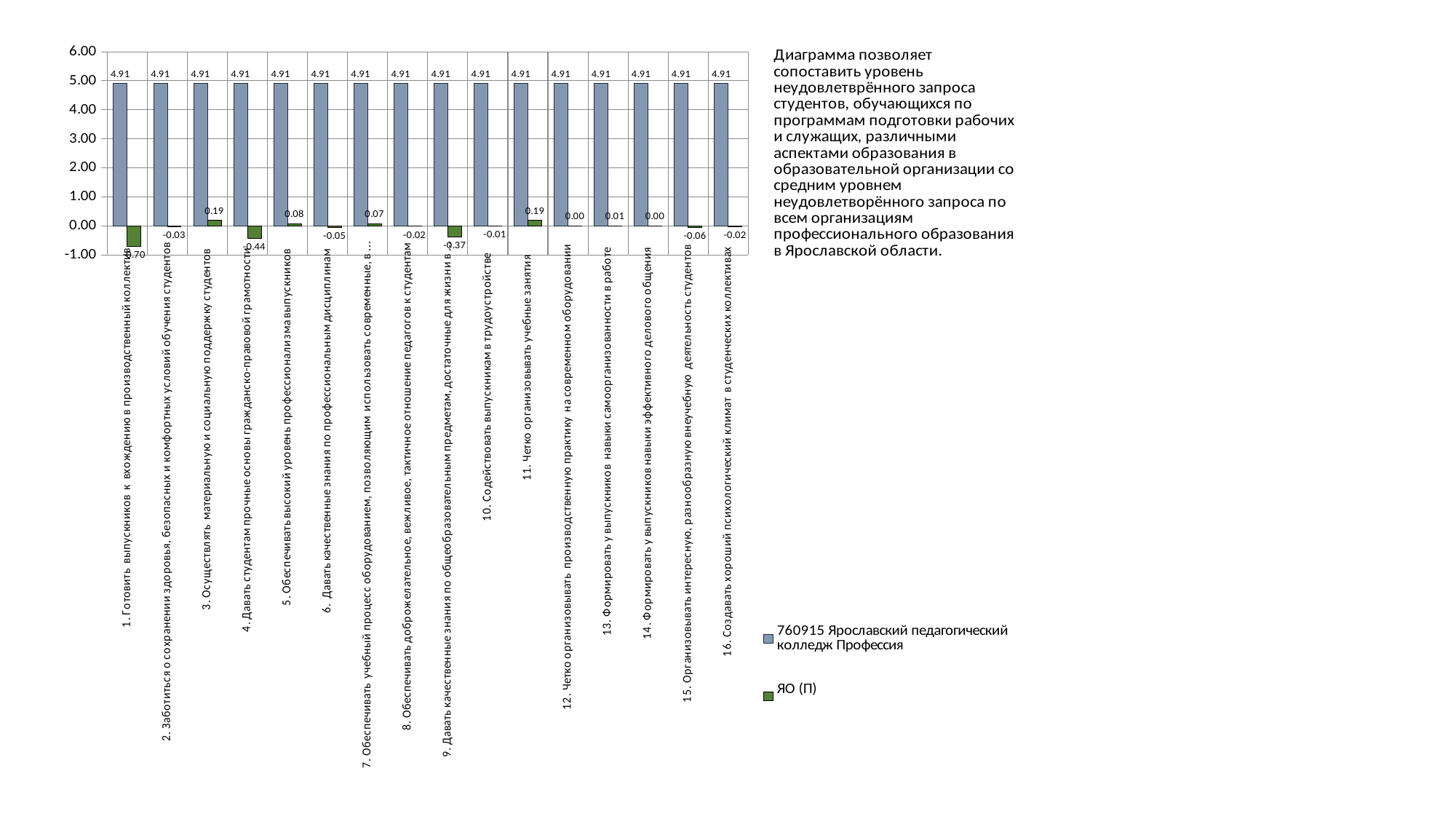
What is the value of the series "ЯО (П)" for category "15. Организовывать интересную, разнообразную внеучебную деятельность студентов"? -0.06 Is the value of the series "ЯО (П)" for category "9. Давать качественные знания по общеобразовательным предметам" greater or less than 0.00? less What type of chart is shown on the slide? bar chart What is the value of the series "760915 Ярославский педагогический колледж Профессия" for category "5. Обеспечивать высокий уровень профессионализма выпускников"? 4.91 For the series "ЯО (П)", which is larger: the value for category 5 (Обеспечивать высокий уровень профессионализма выпускников) or category 6 (Давать качественные знания по профессиональным дисциплинам)? category 5 What is the value of the series "ЯО (П)" for category "3. Осуществлять материальную и социальную поддержку студентов"? 0.19 Which category has the lowest value for the series "ЯО (П)"? 1. Готовить выпускников к вхождению в производственный коллектив What is the difference between the two series' values for category "3. Осуществлять материальную и социальную поддержку студентов"? 4.72 How many series does the legend list? 2 How many categories are plotted along the x axis? 16 Which colour represents the series "ЯО (П)" in the chart? green What is the value of the series "ЯО (П)" for category "13. Формировать у выпускников навыки самоорганизованности в работе"? 0.01